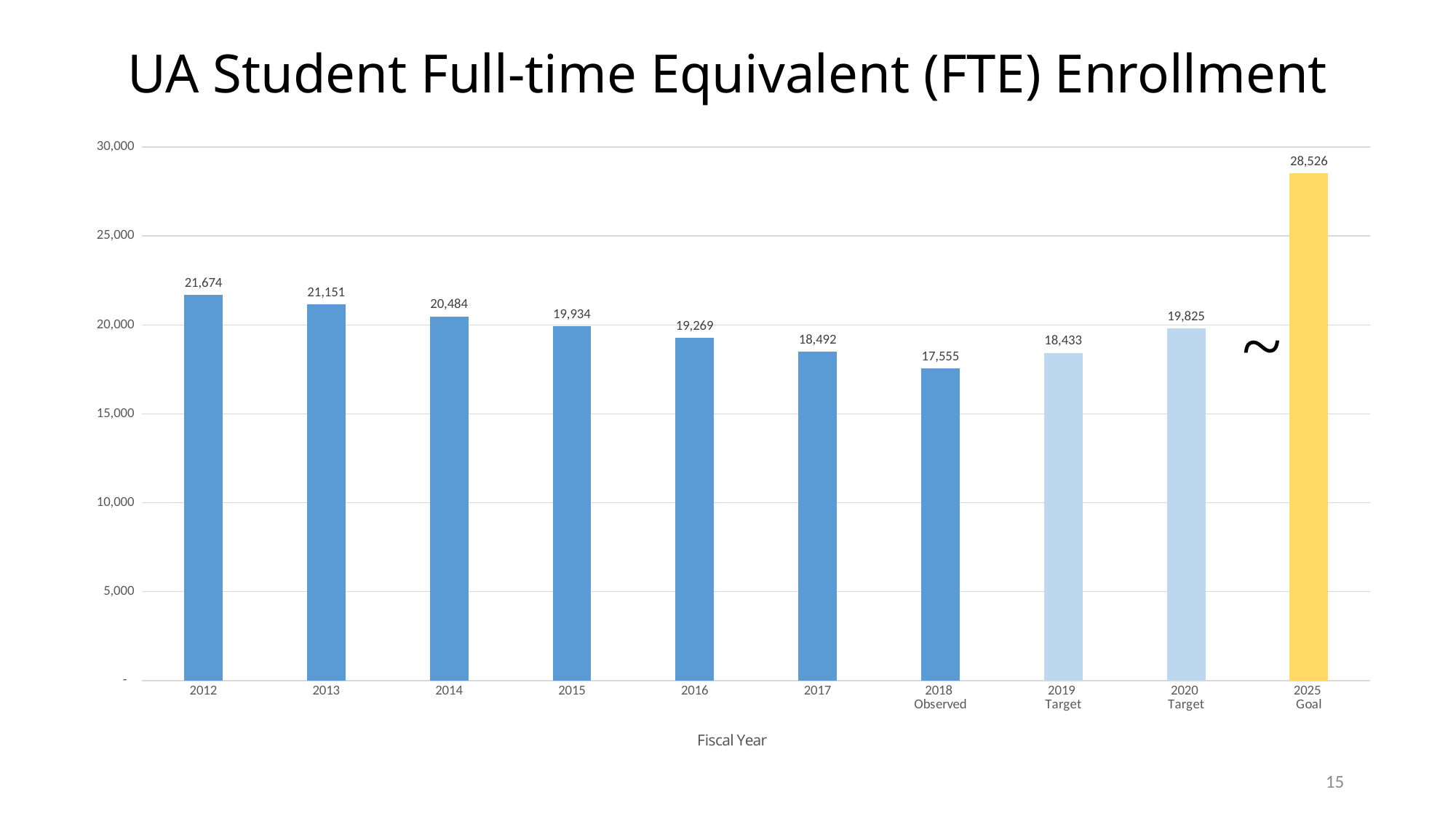
What is the FTE enrollment value for 2018 Observed? 17,555 What is the difference between the 2012 value and the 2018 Observed value? 4,119 How many bars are shown on the chart? 10 What is the value for the 2020 Target? 19,825 What kind of chart is shown on the slide? Bar chart What is the FTE enrollment value for fiscal year 2012? 21,674 Is the value for 2017 greater or less than 20,000? less Which category has the lowest value on the chart? 2018 Observed What is the value shown for the 2025 Goal? 28,526 Which is larger, the value for 2016 or the value for 2019 Target? 2016 Do the values rise or fall from 2012 to 2018 Observed? Fall Which category has the highest value on the chart? 2025 Goal